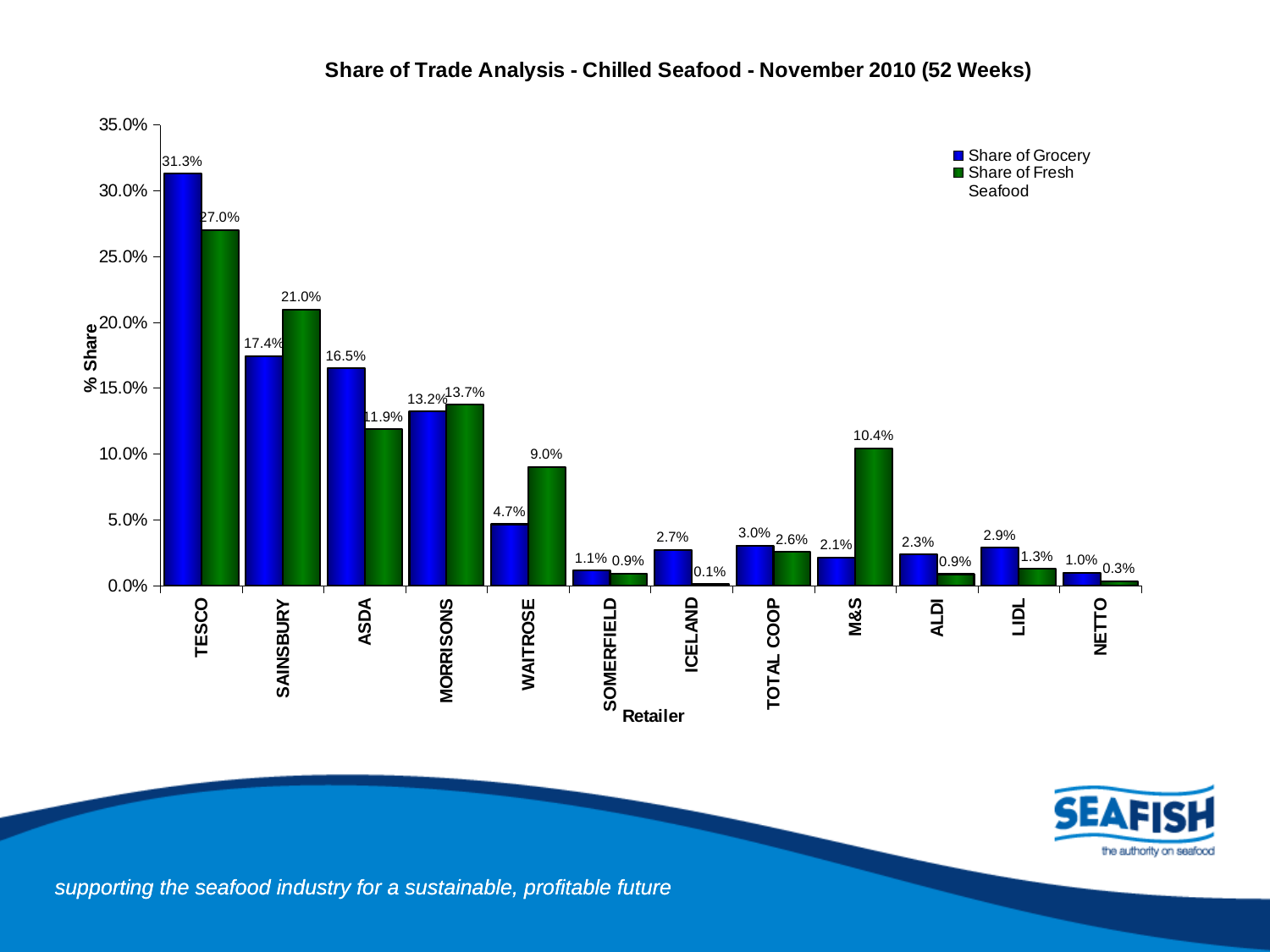
How many series does the legend list? 2 What kind of chart is shown on the slide? Bar chart What is the Share of Fresh Seafood for WAITROSE? 9.0% Which is larger for ASDA, the Share of Grocery or the Share of Fresh Seafood? Share of Grocery What is the Share of Fresh Seafood for M&S? 10.4% Which retailer has the lowest Share of Fresh Seafood? ICELAND Which retailer has the highest Share of Fresh Seafood? TESCO What is the title of the chart? Share of Trade Analysis - Chilled Seafood - November 2010 (52 Weeks) What is the difference between the Share of Grocery and the Share of Fresh Seafood for SAINSBURY? 3.6% Is the Share of Grocery for TESCO greater or less than 30.0%? greater How many retailers are shown on the x axis? 12 What is the Share of Grocery for TESCO? 31.3%